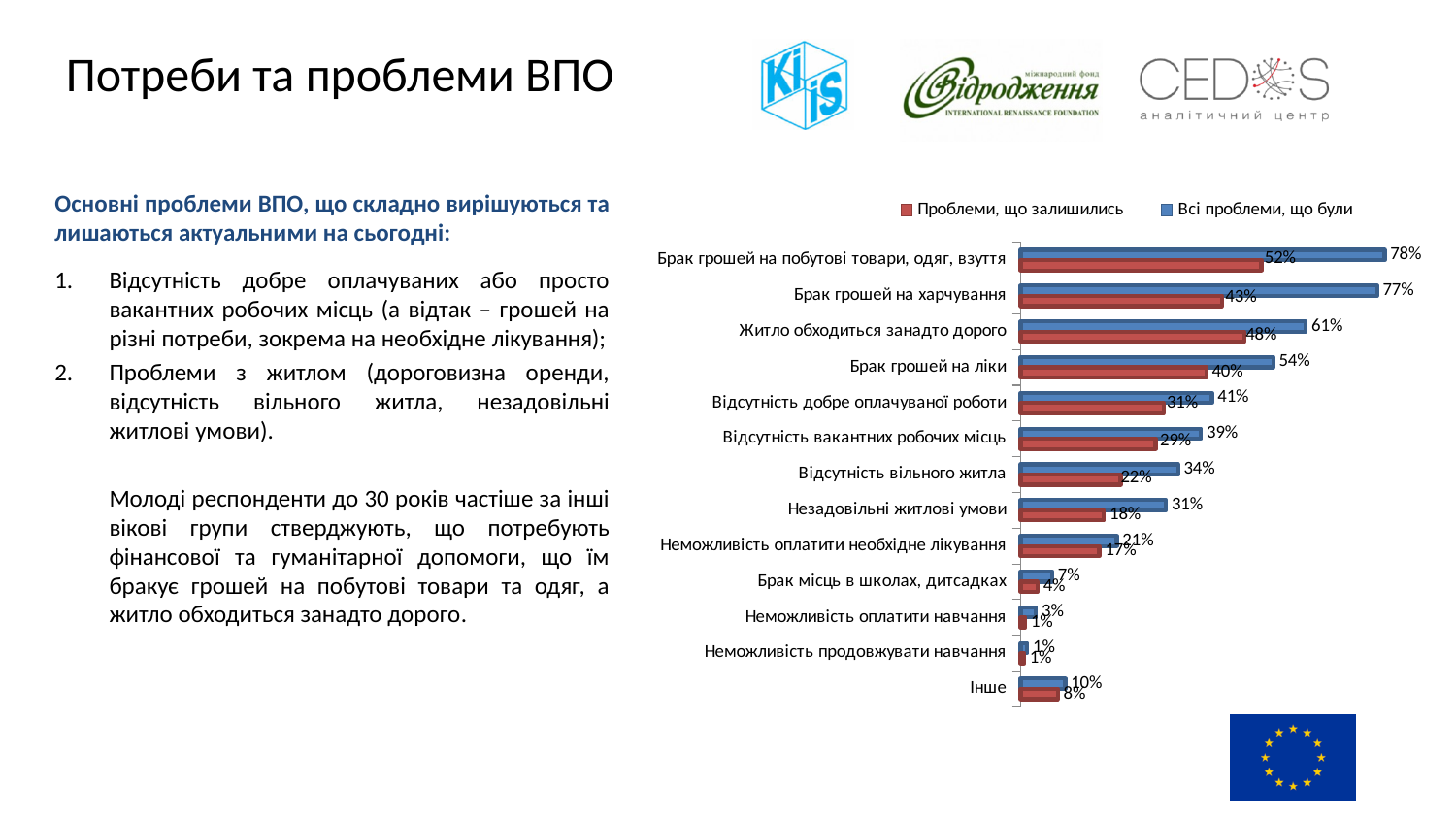
What is the value of "Проблеми, що залишились" for "Житло обходиться занадто дорого"? 48% What is the value of "Всі проблеми, що були" for "Брак грошей на харчування"? 77% Which category has the lowest value for "Всі проблеми, що були"? Неможливість продовжувати навчання What is the difference between "Всі проблеми, що були" and "Проблеми, що залишились" for "Незадовільні житлові умови"? 13% How many series does the chart legend list? 2 What is the value of "Проблеми, що залишились" for "Інше"? 8% What is the difference between "Всі проблеми, що були" and "Проблеми, що залишились" for "Брак грошей на харчування"? 34% What type of chart is shown on the slide? bar chart Which category has the highest value for "Всі проблеми, що були"? Брак грошей на побутові товари, одяг, взуття How many categories are shown in the chart? 13 Which is larger for "Проблеми, що залишились": "Брак грошей на ліки" or "Відсутність добре оплачуваної роботи"? Брак грошей на ліки Which colour represents the series "Проблеми, що залишились" in the chart? red